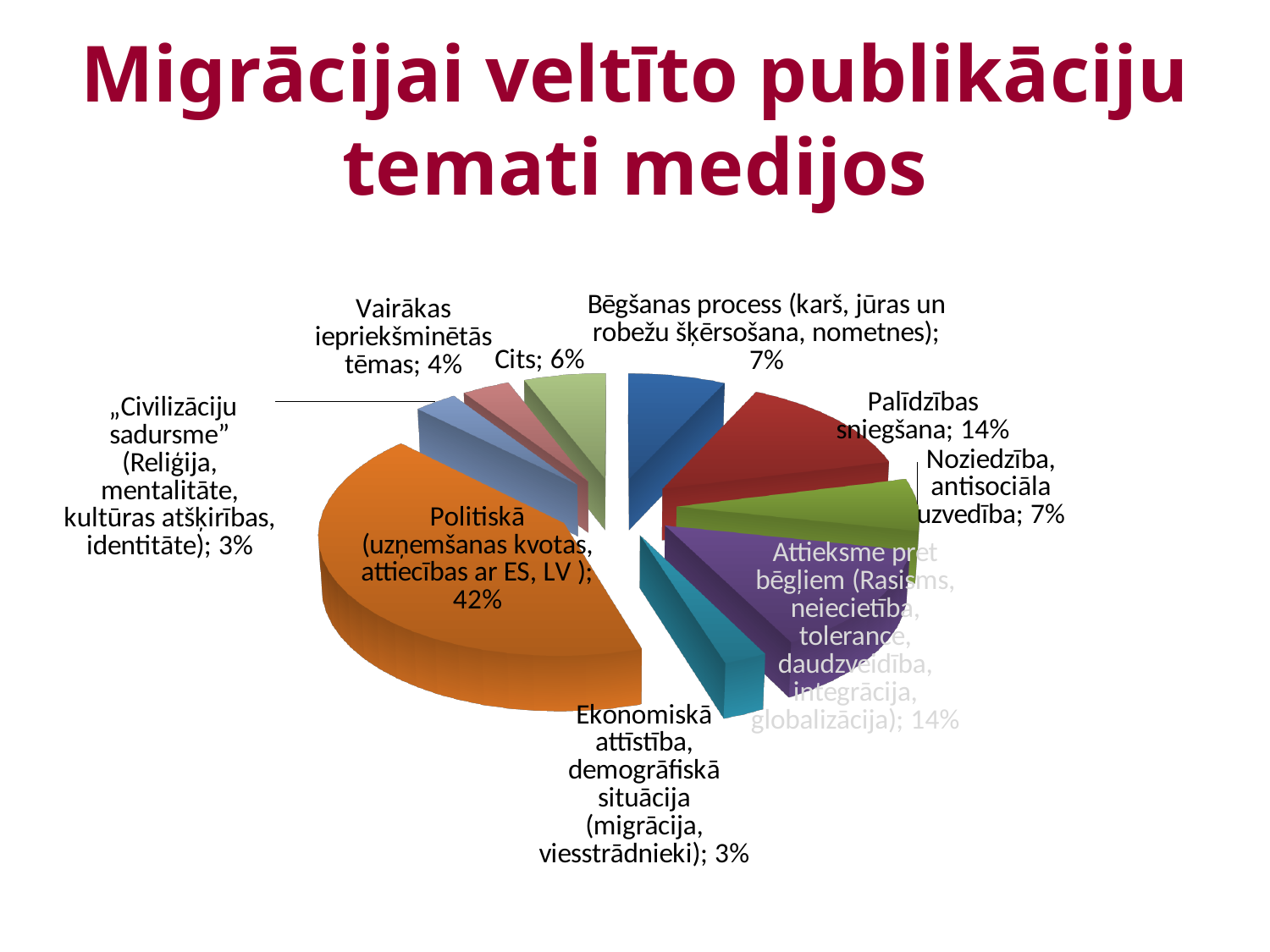
Which category has the largest share of the pie? Politiskā (uzņemšanas kvotas, attiecības ar ES, LV ) What share of the pie is labelled "Politiskā (uzņemšanas kvotas, attiecības ar ES, LV )"? 42% Which has a larger share: "Cits" or "Vairākas iepriekšminētās tēmas"? Cits What percentage is shown for "Vairākas iepriekšminētās tēmas"? 4% What is the title of the slide containing the chart? Migrācijai veltīto publikāciju temati medijos What is the difference in percentage points between "Bēgšanas process (karš, jūras un robežu šķērsošana, nometnes)" and "Ekonomiskā attīstība, demogrāfiskā situācija (migrācija, viesstrādnieki)"? 4 How many slices does the pie chart have? 9 What kind of chart is shown on the slide? Pie chart What percentage is shown for "Noziedzība, antisociāla uzvedība"? 7% What is the difference in percentage points between "Politiskā (uzņemšanas kvotas, attiecības ar ES, LV )" and "Palīdzības sniegšana"? 28 What percentage is shown for "Cits"? 6% What percentage is shown for "Palīdzības sniegšana"? 14%